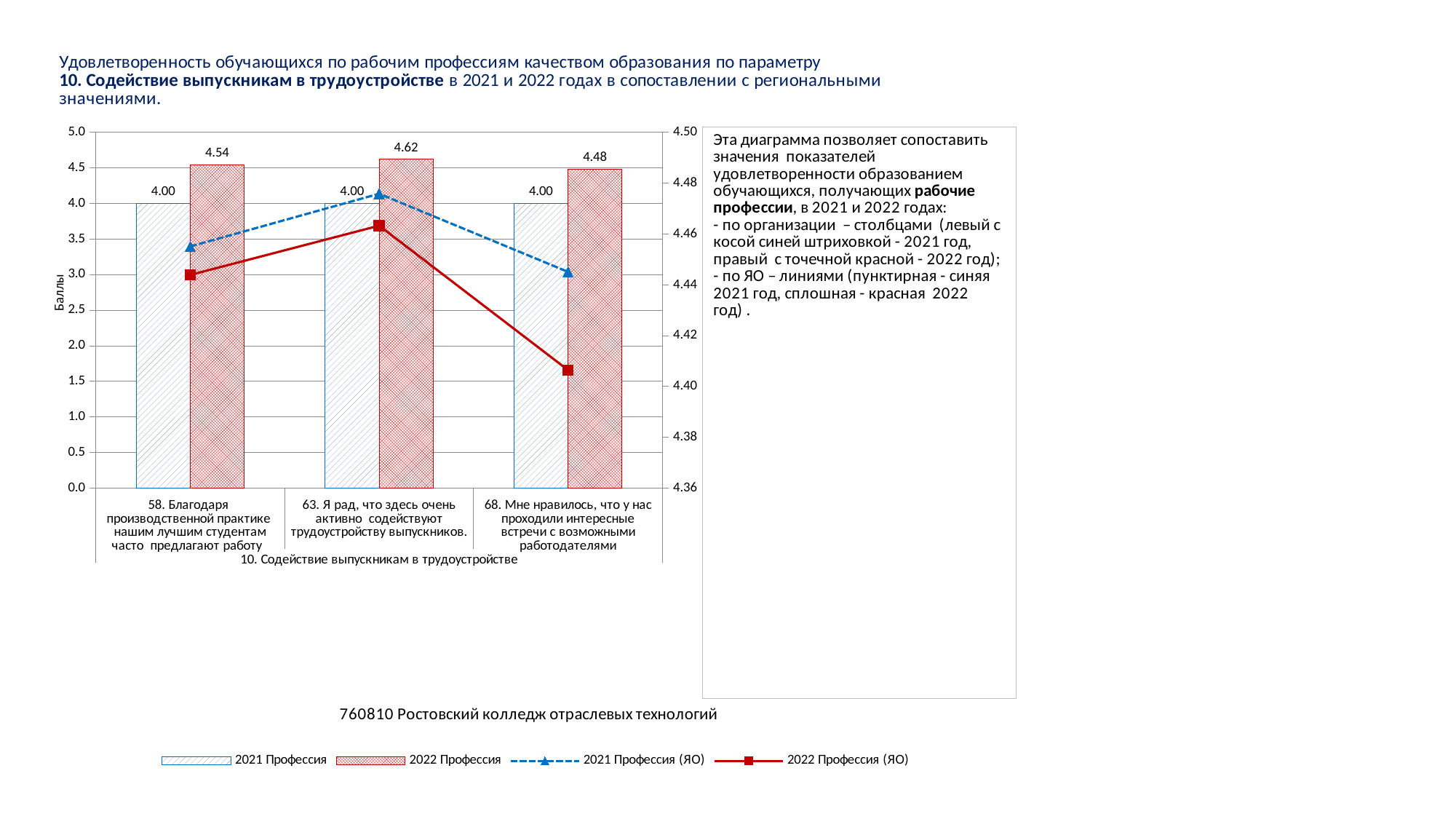
Is the value of the 2021 Профессия (ЯО) line for item 63 greater or less than 4.46 on the right axis? greater Which is larger for item 68: the 2021 Профессия bar or the 2022 Профессия bar? 2022 Профессия Which item has the lowest 2022 Профессия bar? 68. Мне нравилось, что у нас проходили интересные встречи с возможными работодателями Which item has the highest 2022 Профессия bar? 63. Я рад, что здесь очень активно содействуют трудоустройству выпускников. What is the value of the 2022 Профессия bar for item 58 (Благодаря производственной практике нашим лучшим студентам часто предлагают работу)? 4.54 What kind of chart is shown on the slide? Combined bar and line chart How many series does the legend list? 4 What is the difference between the 2022 Профессия bars for item 63 and item 68? 0.14 What is the difference between the 2022 Профессия and 2021 Профессия bars for item 58? 0.54 How many items (categories) are shown on the x axis? 3 What is the value of the 2021 Профессия bar for item 68 (Мне нравилось, что у нас проходили интересные встречи с возможными работодателями)? 4.00 What is the value of the 2022 Профессия bar for item 63 (Я рад, что здесь очень активно содействуют трудоустройству выпускников)? 4.62